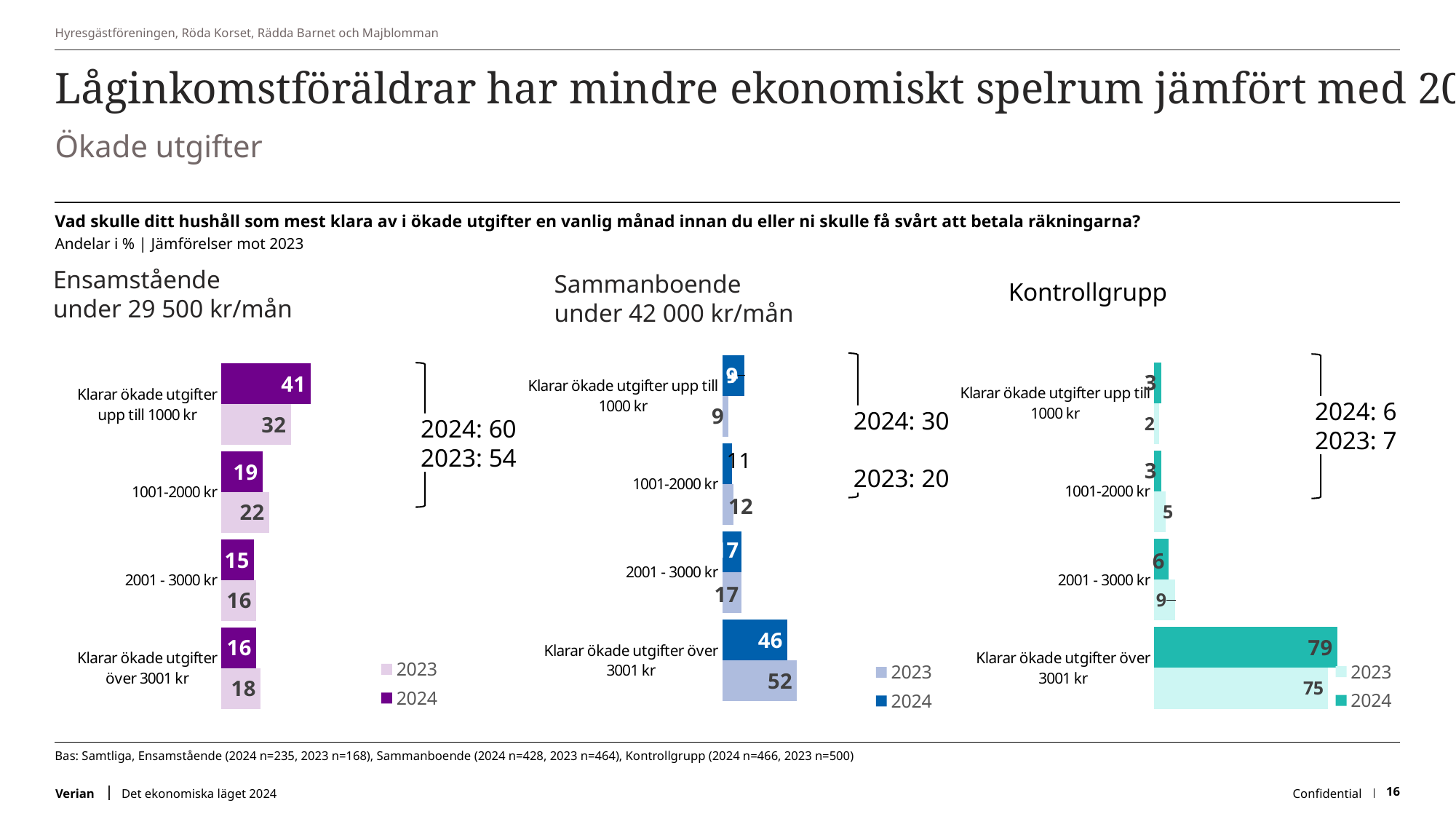
In the Kontrollgrupp chart, what is the 2023 value for '2001 - 3000 kr'? 9 In the Kontrollgrupp chart, what is the 2024 value for 'Klarar ökade utgifter över 3001 kr'? 79 How many series does the legend of the Kontrollgrupp chart list? 2 In the Sammanboende under 42 000 kr/mån chart, what is the 2023 value for 'Klarar ökade utgifter över 3001 kr'? 52 In the Ensamstående under 29 500 kr/mån chart, what is the 2024 value for 'Klarar ökade utgifter upp till 1000 kr'? 41 In the Sammanboende under 42 000 kr/mån chart, which category has the highest 2024 value? Klarar ökade utgifter över 3001 kr In the Kontrollgrupp chart, which category has the lowest 2023 value? Klarar ökade utgifter upp till 1000 kr What type of chart is the Sammanboende under 42 000 kr/mån chart? bar chart In the Ensamstående under 29 500 kr/mån chart, what is the difference between the 2024 and 2023 values for 'Klarar ökade utgifter upp till 1000 kr'? 9 In the Ensamstående under 29 500 kr/mån chart, what is the 2023 value for '1001-2000 kr'? 22 How many categories does the Ensamstående under 29 500 kr/mån chart show? 4